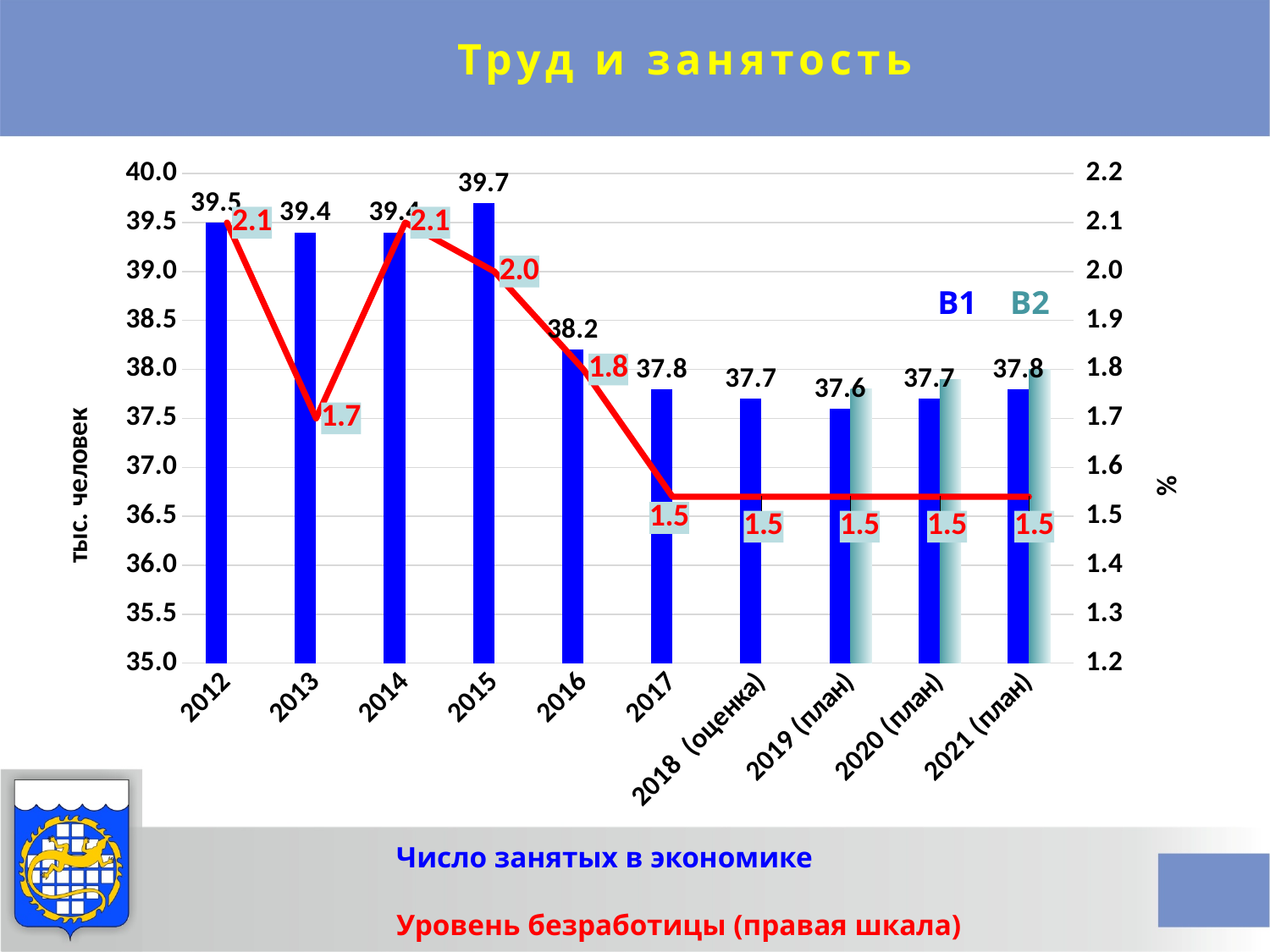
Which is larger, the 'Уровень безработицы' value for 2014 or for 2016? 2014 What is the value of 'Число занятых в экономике' for 2015? 39.7 What is the title of the slide? Труд и занятость How many years (categories) are shown on the x axis? 10 Which year has the lowest value of 'Число занятых в экономике'? 2019 (план) How many series does the legend list? 2 Does the 'Уровень безработицы' line rise or fall from 2014 to 2017? Fall What is the value of 'Уровень безработицы (правая шкала)' for 2013? 1.7 Which year has the highest value of 'Число занятых в экономике'? 2015 What kind of chart is shown on the slide? Combined bar and line chart What is the value of 'Число занятых в экономике' for 2019 (план)? 37.6 What is the difference between the 'Число занятых в экономике' values for 2015 and 2016? 1.5